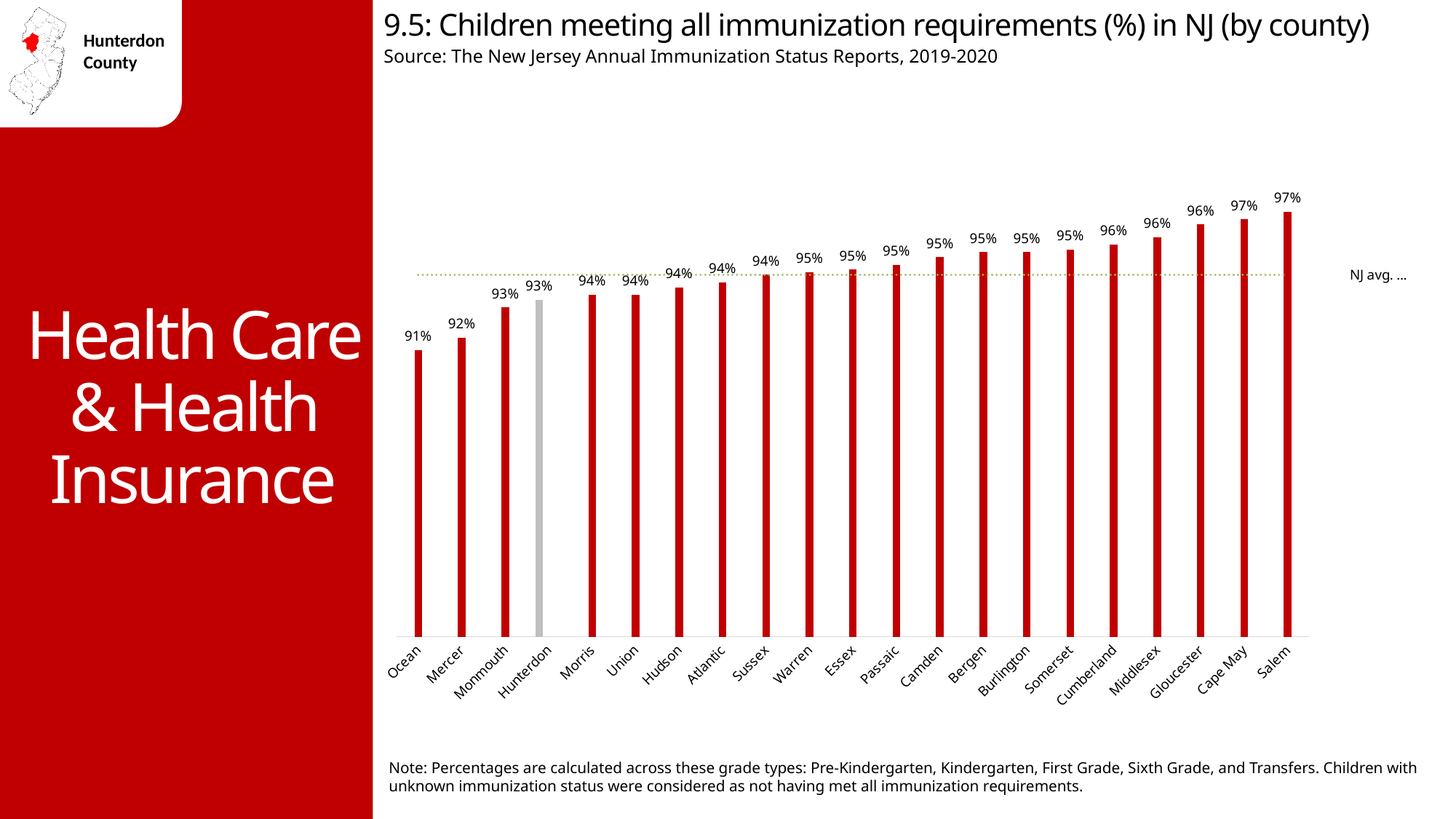
What is the value shown for Ocean County? 91% What is the difference in percentage points between Hunterdon and Ocean? 2 percentage points What kind of chart is used on this slide? Bar chart Do the values rise or fall moving from left to right along the x axis? Rise Which has a higher value, Mercer or Monmouth? Monmouth Which county has the lowest percentage of children meeting all immunization requirements? Ocean What percentage is shown for Cumberland County? 96% Which has a higher value, Hunterdon or Cumberland? Cumberland What percentage of children in Hunterdon County met all immunization requirements? 93% What is the value shown for Mercer County? 92% What is the difference in percentage points between Salem (97%) and Ocean (91%)? 6 percentage points How many counties are shown in the chart? 21